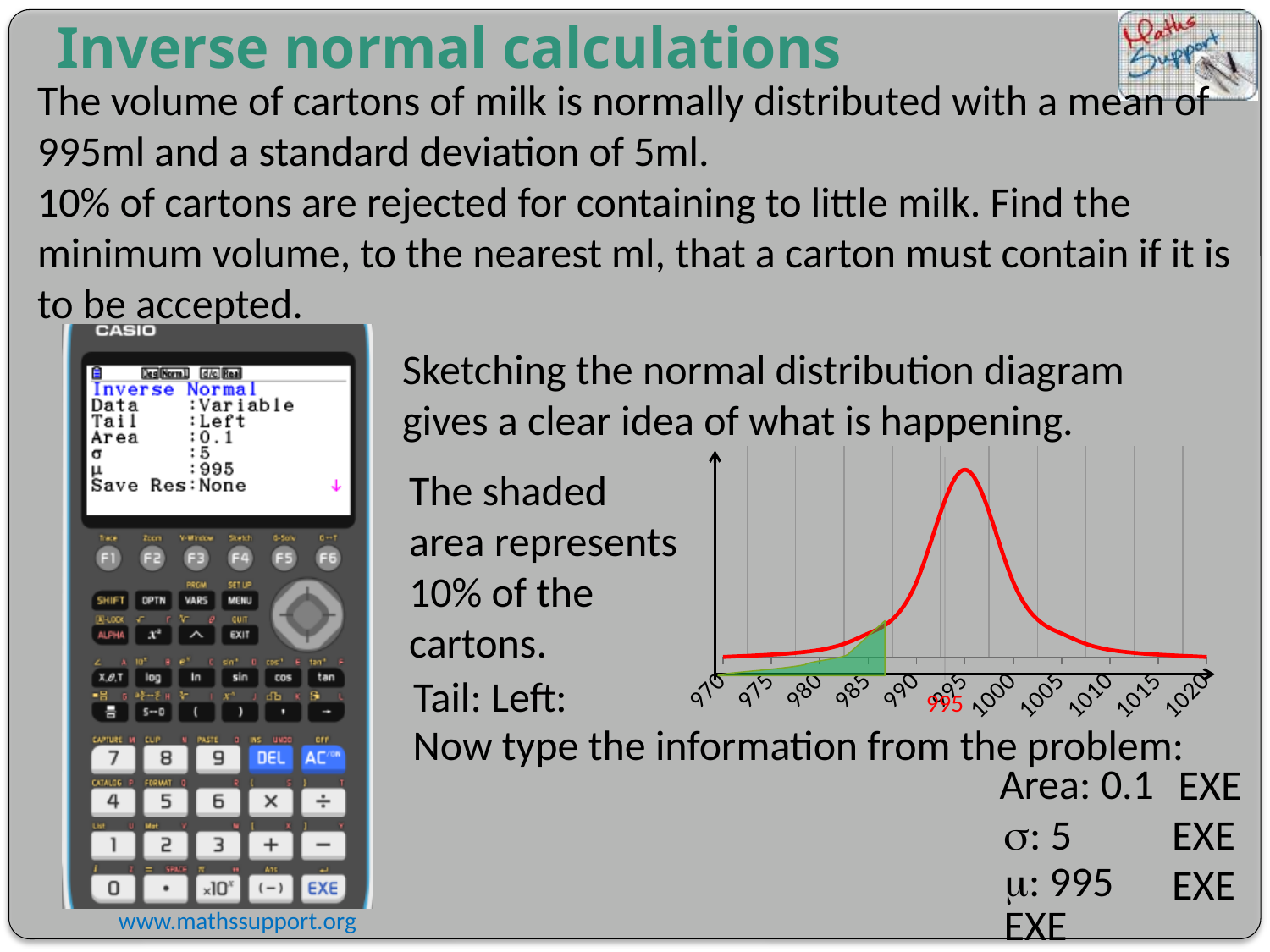
What kind of chart is shown on the right of the slide? line chart How many labelled tick values are shown on the x axis of the chart? 11 At which x-axis value does the curve reach its highest point? 995 Is the curve higher at 990 or at 1010? 990 What is the largest value labelled on the x axis of the chart? 1020 Is the curve higher at 980 or at 1000? 1000 What is the spacing between consecutive labelled ticks on the x axis? 5 Does the curve rise or fall as x increases from 995 to 1020? fall What colour is the shaded area under the left tail of the curve? green What is the smallest value labelled on the x axis of the chart? 970 What colour is the normal distribution curve drawn in? red Does the curve rise or fall as x increases from 970 to 995? rise